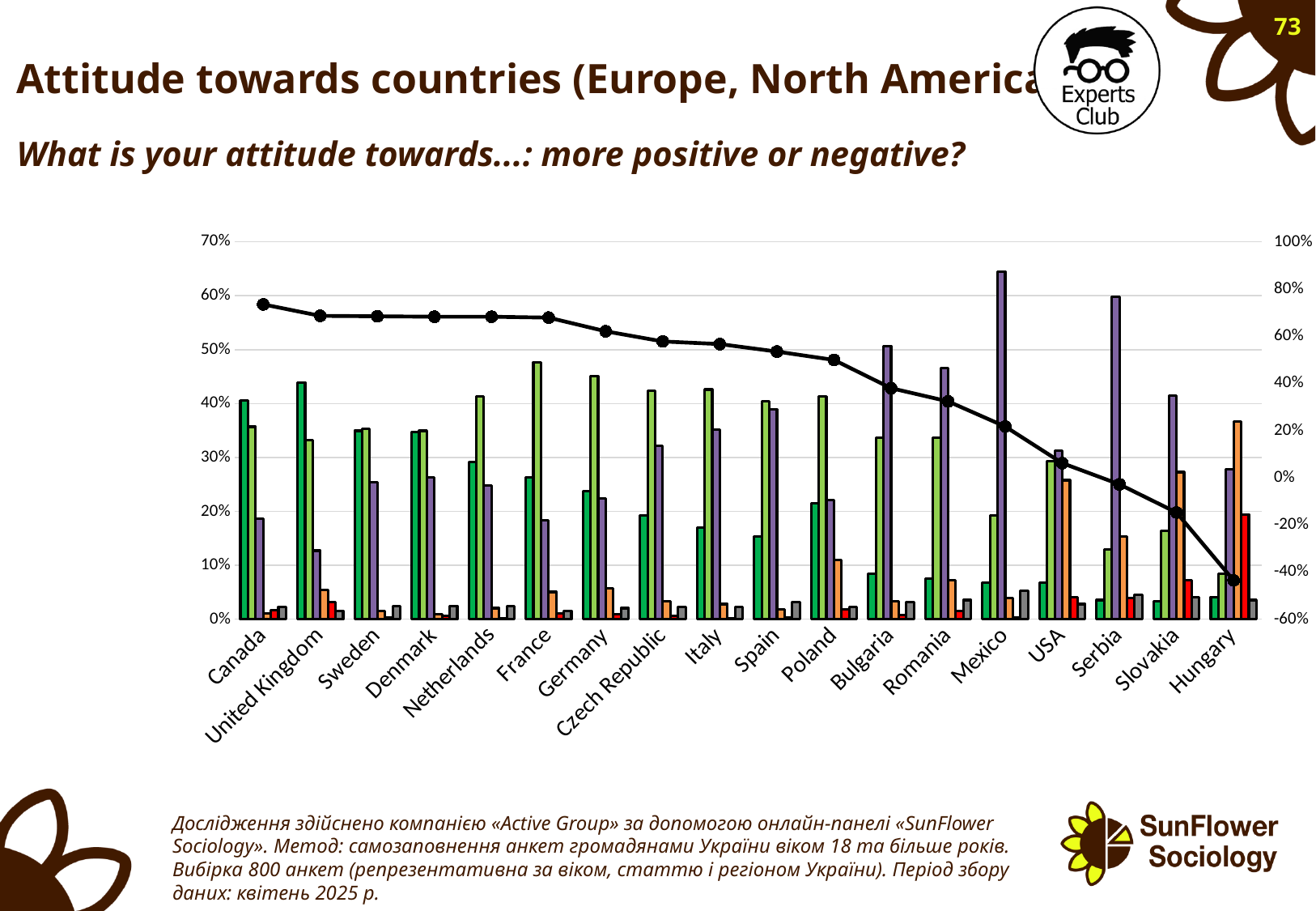
Which country has the tallest single bar in the chart? Mexico Is the black line value for Canada (right axis) greater or less than 60%? greater For which country is the black line at its highest point? Canada How many countries are shown on the x axis of the chart? 18 What kind of chart is shown on the slide? Bar chart combined with a line What is the maximum value shown on the left vertical axis? 70% Is the black line value for Poland (right axis) greater or less than 40%? greater For which country is the black line at its lowest point? Hungary Does the black line with markers rise or fall from Canada on the left to Hungary on the right? Falls Is the black line value for Hungary (right axis) greater or less than 0%? less Which has the higher black line value, France or Spain? France